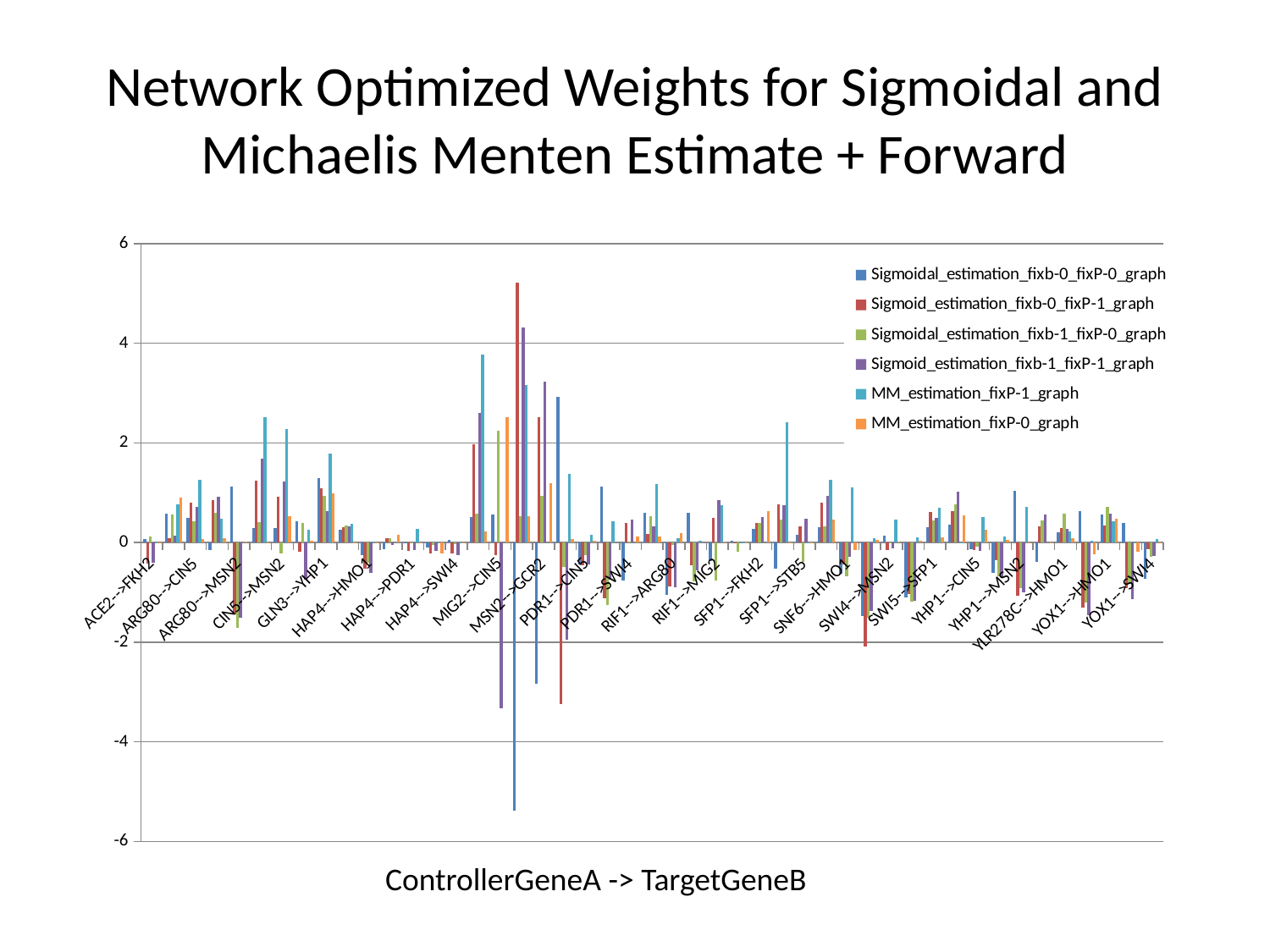
What kind of chart is shown on the slide? Bar chart Which series contains the tallest positive bar on the chart? Sigmoid_estimation_fixb-0_fixP-1_graph What is the maximum value shown on the vertical axis? 6 Is the lowest value plotted on the chart greater or less than -4? less What is the label on the x axis of the chart? ControllerGeneA -> TargetGeneB How many series does the legend list? 6 What is the minimum value shown on the vertical axis? -6 What is the title of the chart? Network Optimized Weights for Sigmoidal and Michaelis Menten Estimate + Forward Which series contains the lowest negative bar on the chart? Sigmoidal_estimation_fixb-0_fixP-0_graph